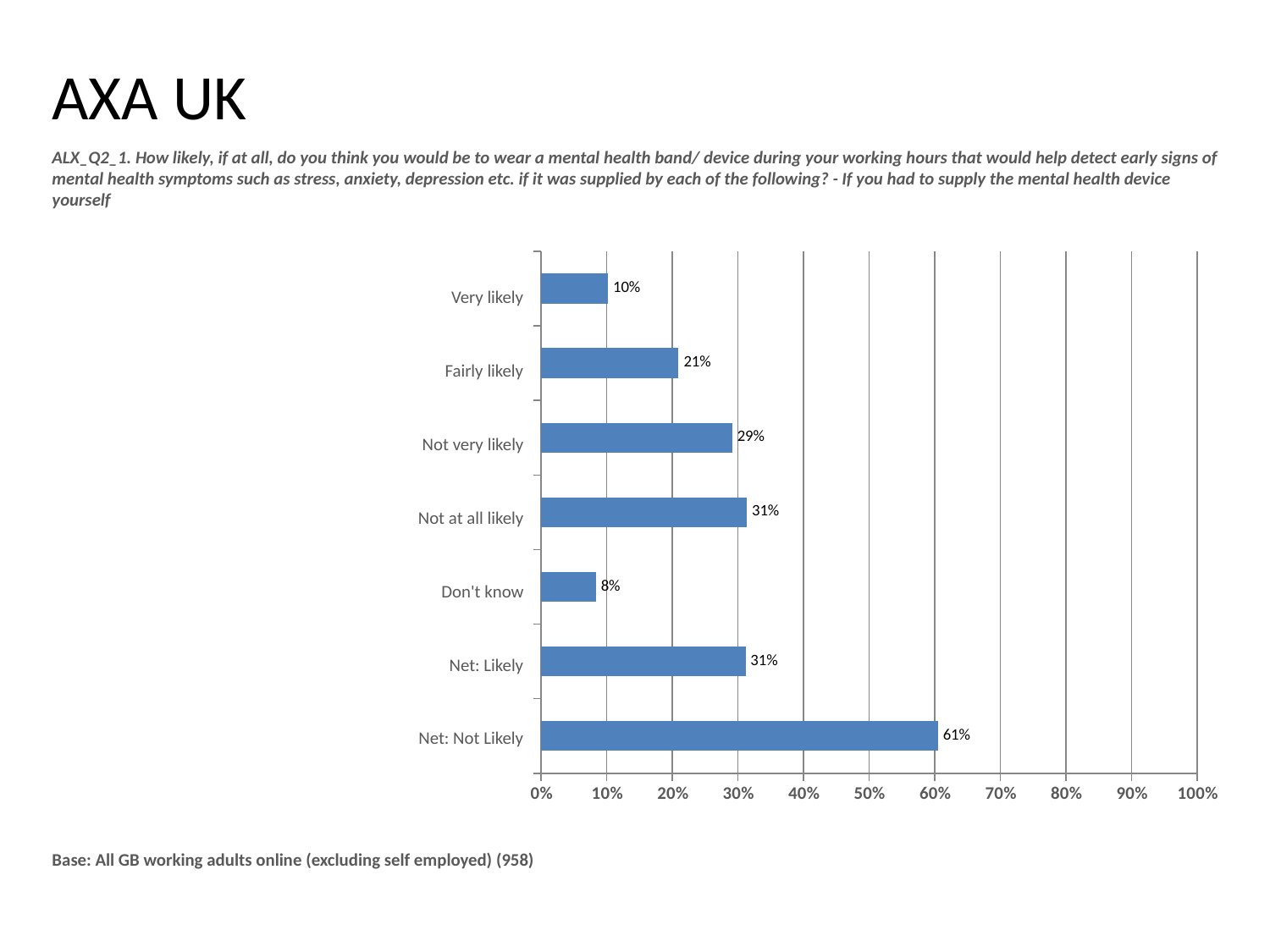
What is the difference between Fairly likely and Very likely? 11% What is the value for Very likely? 10% Is the value for Net: Not Likely greater or less than 50%? greater What kind of chart is shown on the slide? Bar chart What is the value for Don't know? 8% What is the value for Net: Not Likely? 61% How many categories are shown on the chart? 7 Which is larger, Not very likely or Fairly likely? Not very likely What is the difference between Net: Not Likely and Net: Likely? 30% Which category has the lowest value? Don't know Which category has the highest value? Net: Not Likely What is the value for Not very likely? 29%